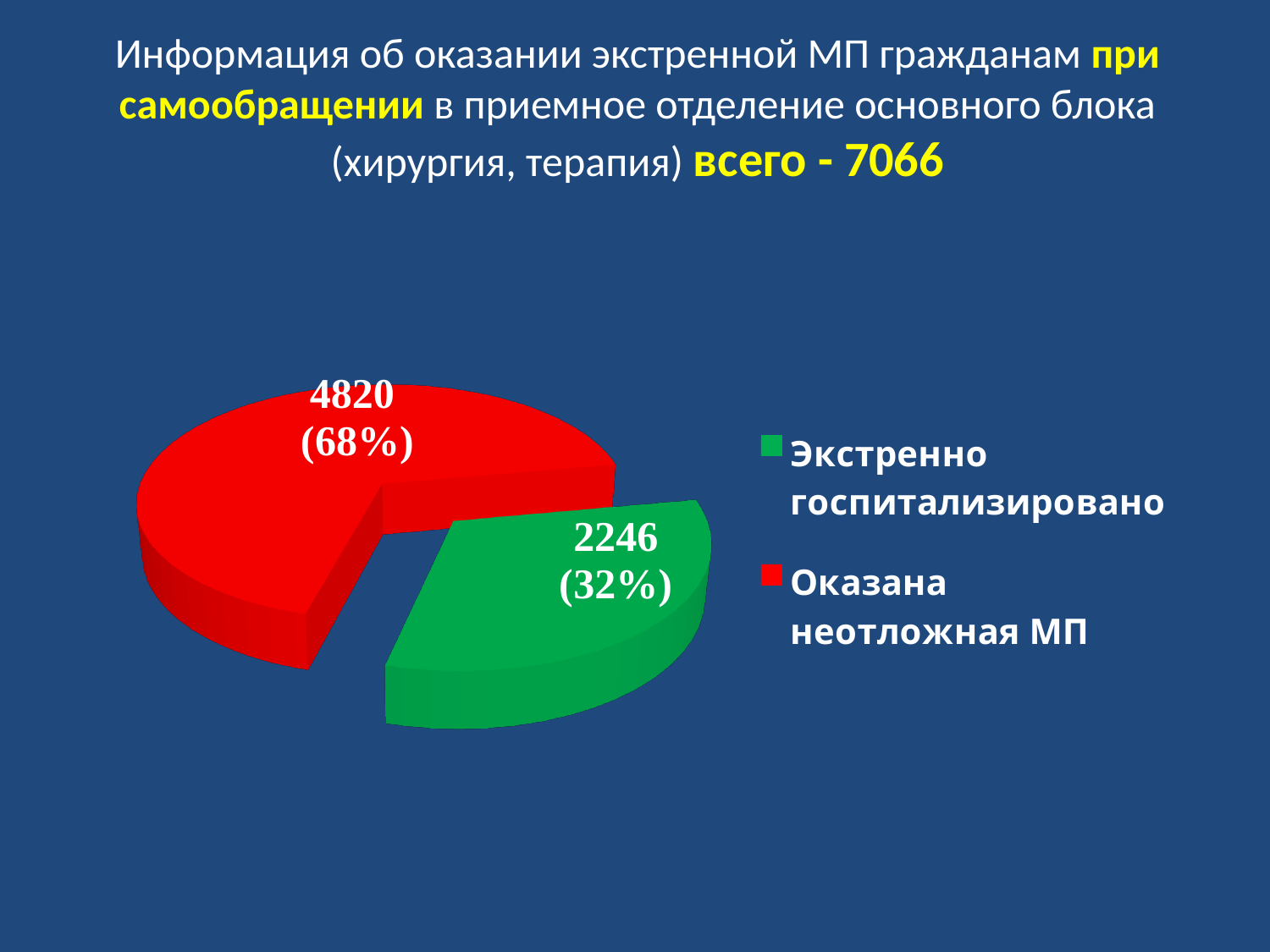
Which is larger: "Экстренно госпитализировано" or "Оказана неотложная МП"? Оказана неотложная МП What share of the pie does "Оказана неотложная МП" represent? 68% Which category has the smallest slice? Экстренно госпитализировано What colour is the slice for "Экстренно госпитализировано"? green What share of the pie does "Экстренно госпитализировано" represent? 32% How many slices does the pie chart have? 2 What kind of chart is shown on the slide? pie chart How many entries does the legend list? 2 What is the value for "Оказана неотложная МП"? 4820 What is the difference between the values for "Оказана неотложная МП" and "Экстренно госпитализировано"? 2574 What is the value for "Экстренно госпитализировано"? 2246 Which category has the largest slice? Оказана неотложная МП